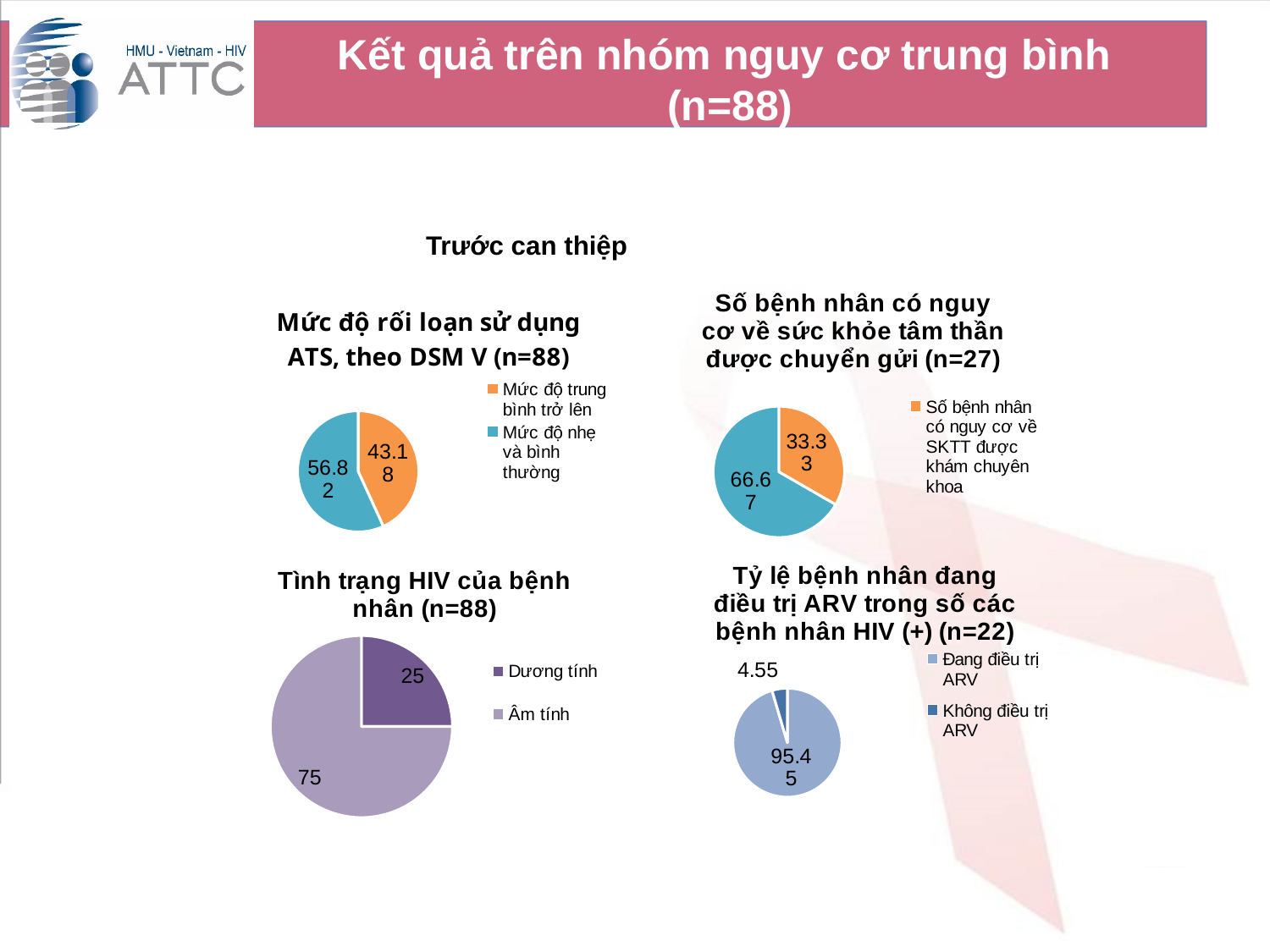
In the chart titled "Số bệnh nhân có nguy cơ về sức khỏe tâm thần được chuyển gửi (n=27)", what is the value of the orange slice (Số bệnh nhân có nguy cơ về SKTT được khám chuyên khoa)? 33.33 In the chart titled "Tình trạng HIV của bệnh nhân (n=88)", what is the difference between the values for Âm tính and Dương tính? 50 What kind of chart is used for "Tình trạng HIV của bệnh nhân (n=88)"? Pie chart In the chart titled "Mức độ rối loạn sử dụng ATS, theo DSM V (n=88)", which category is the smallest? Mức độ trung bình trở lên In the chart titled "Tình trạng HIV của bệnh nhân (n=88)", which category is the largest? Âm tính In the chart titled "Tỷ lệ bệnh nhân đang điều trị ARV trong số các bệnh nhân HIV (+) (n=22)", what is the value for Đang điều trị ARV? 95.45 In the chart titled "Mức độ rối loạn sử dụng ATS, theo DSM V (n=88)", what is the value for Mức độ trung bình trở lên? 43.18 In the chart titled "Tình trạng HIV của bệnh nhân (n=88)", what is the value for Âm tính? 75 In the chart titled "Tỷ lệ bệnh nhân đang điều trị ARV trong số các bệnh nhân HIV (+) (n=22)", what is the value for Không điều trị ARV? 4.55 In the chart titled "Tình trạng HIV của bệnh nhân (n=88)", what is the value for Dương tính? 25 In the chart titled "Mức độ rối loạn sử dụng ATS, theo DSM V (n=88)", what is the value for Mức độ nhẹ và bình thường? 56.82 How many series does the legend list for the chart titled "Tỷ lệ bệnh nhân đang điều trị ARV trong số các bệnh nhân HIV (+) (n=22)"? 2